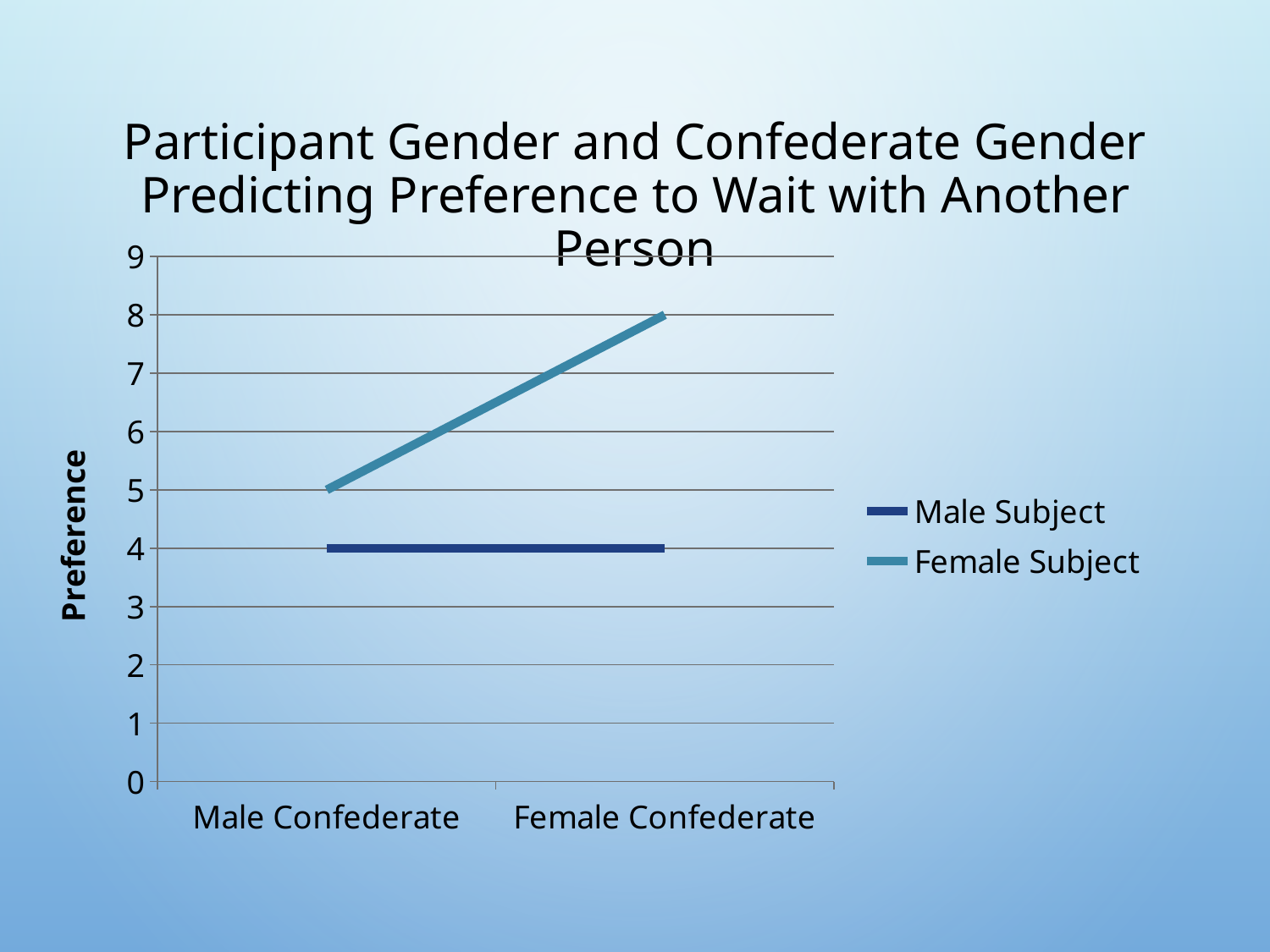
Does the Male Subject line rise, fall, or stay flat from Male Confederate to Female Confederate? stay flat What is the Preference value for Male Subject at Female Confederate? 4 What is the label of the vertical axis? Preference Which series has the higher value at Female Confederate, Male Subject or Female Subject? Female Subject What is the Preference value for Male Subject at Male Confederate? 4 What kind of chart is shown on the slide? line chart What is the Preference value for Female Subject at Female Confederate? 8 How many categories are shown on the x axis? 2 Does the Female Subject line rise or fall from Male Confederate to Female Confederate? rise What is the difference between the Female Subject values at Female Confederate and Male Confederate? 3 What is the Preference value for Female Subject at Male Confederate? 5 How many series does the legend list? 2